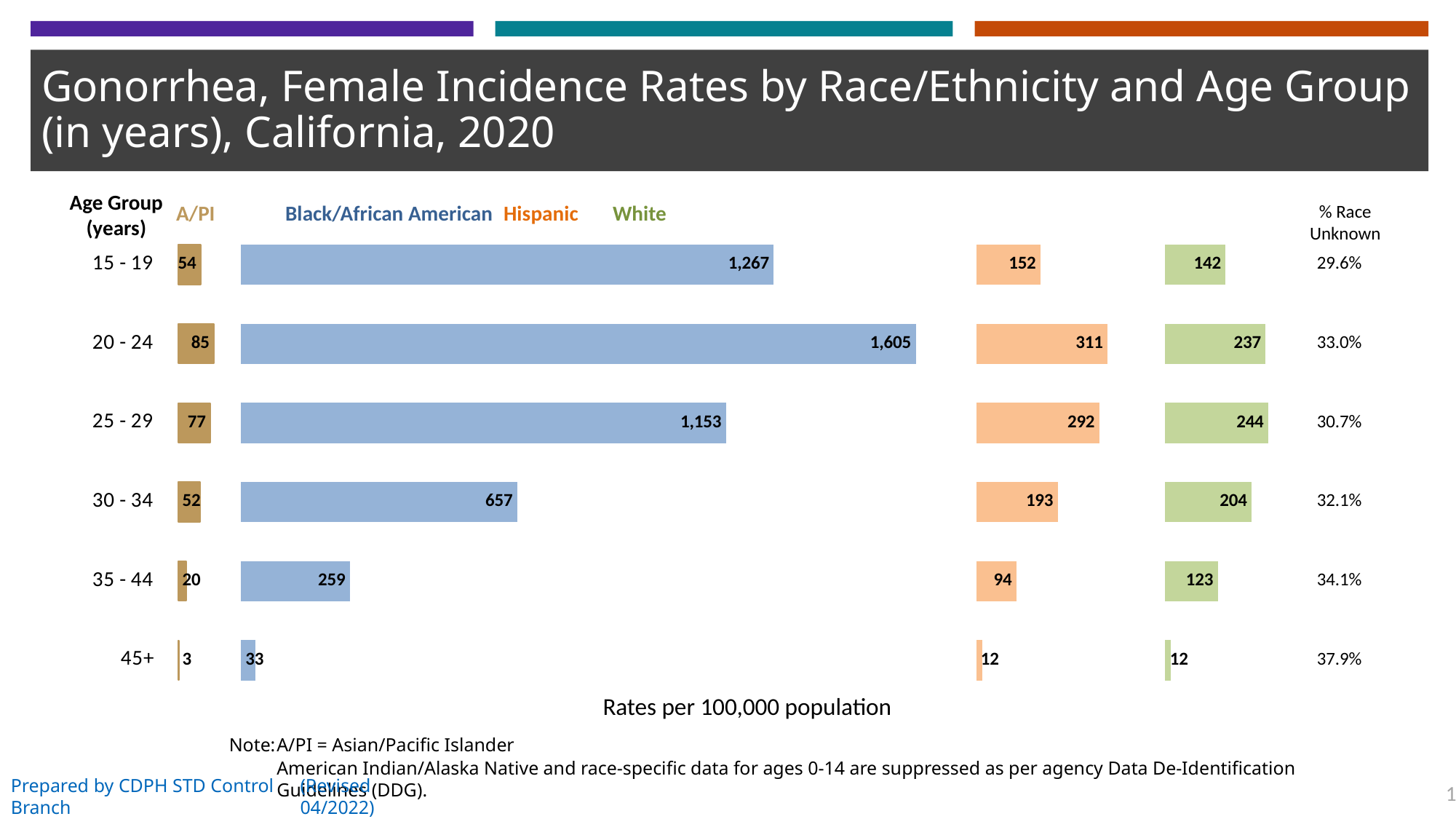
What is the gonorrhea incidence rate for Black/African American females aged 20 - 24? 1,605 For the 30 - 34 age group, which is larger: the Hispanic rate or the White rate? White What kind of chart is shown on the slide? Bar chart What is the % Race Unknown value for the 45+ age group? 37.9% How many race/ethnicity series does the chart show? 4 What is the gonorrhea incidence rate for A/PI females aged 30 - 34? 52 Which age group has the lowest gonorrhea incidence rate among Hispanic females? 45+ Which age group has the highest gonorrhea incidence rate among Black/African American females? 20 - 24 What is the difference between the Black/African American and Hispanic rates for the 15 - 19 age group? 1,115 What is the gonorrhea incidence rate for Hispanic females aged 25 - 29? 292 What is the gonorrhea incidence rate for White females aged 35 - 44? 123 How many age groups are shown in the chart? 6